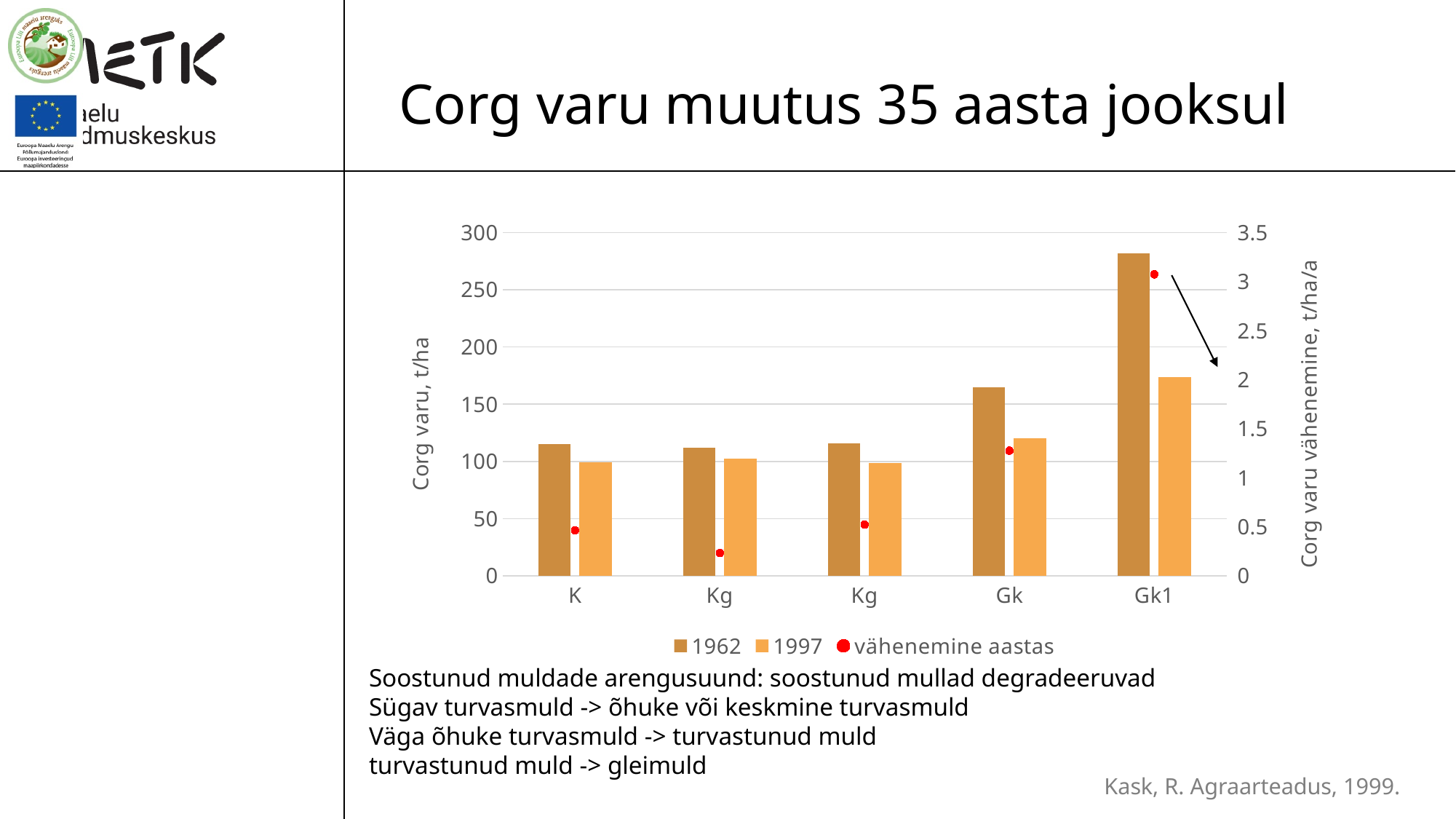
Which category has the highest value for the 1962 series? Gk1 What kind of chart is shown on the slide? bar chart Is the 'vähenemine aastas' value for K greater or less than 1? less Is the 1962 value for Gk greater or less than 150? greater What is the title of the chart on the slide? Corg varu muutus 35 aasta jooksul Which category has the highest value for the 'vähenemine aastas' series? Gk1 How many categories are shown on the x axis of the chart? 5 Is the 1997 value for Gk1 greater or less than 200? less For Gk1, which is larger: the 1962 value or the 1997 value? 1962 How many series does the chart legend list? 3 What is the label of the left vertical axis of the chart? Corg varu, t/ha